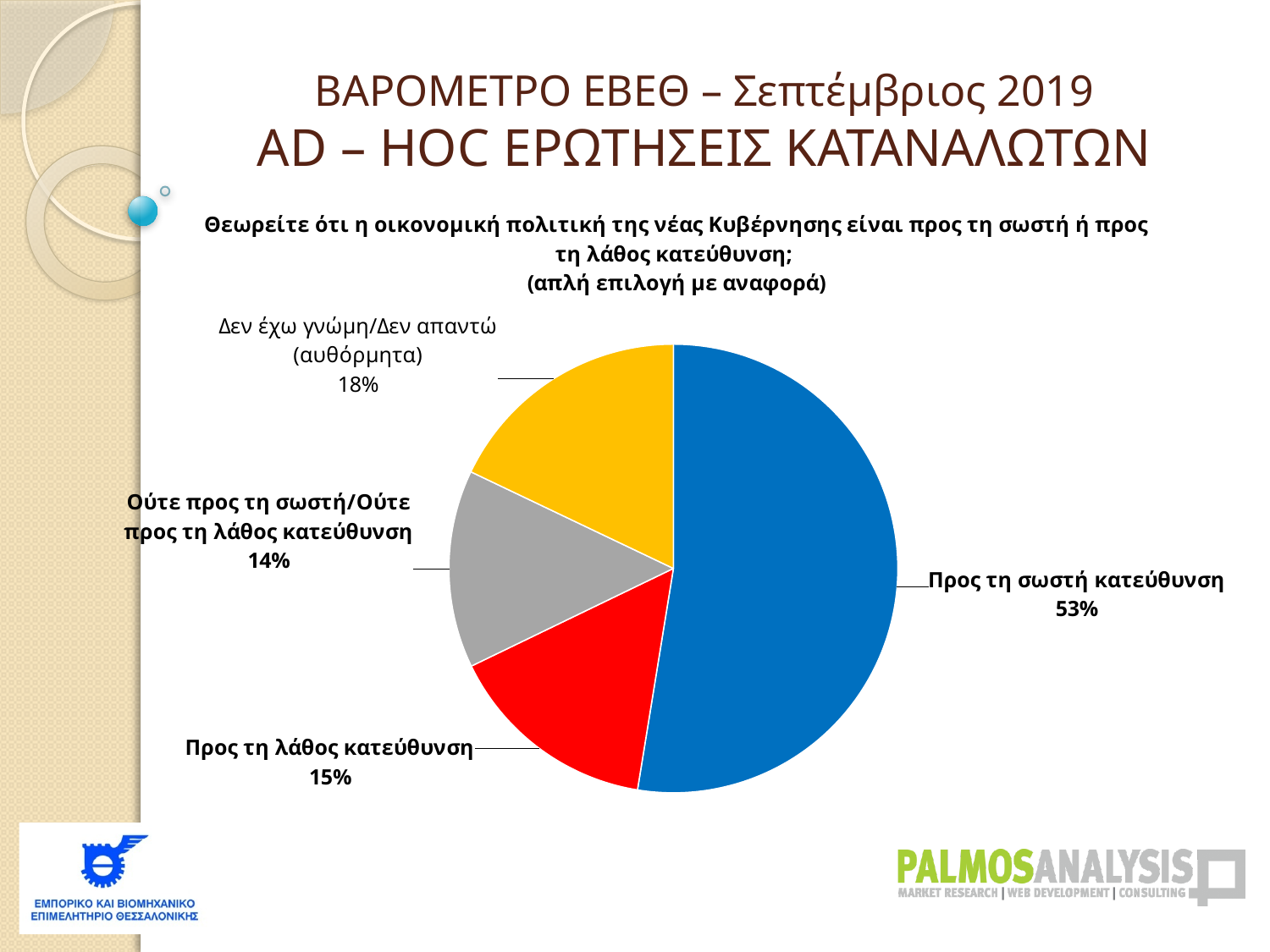
Which is larger: the share for "Δεν έχω γνώμη/Δεν απαντώ (αυθόρμητα)" or the share for "Προς τη λάθος κατεύθυνση"? Δεν έχω γνώμη/Δεν απαντώ (αυθόρμητα) What percentage of respondents answered "Προς τη λάθος κατεύθυνση"? 15% What kind of chart is shown on the slide? pie chart What percentage of respondents answered "Προς τη σωστή κατεύθυνση"? 53% What colour is the slice for "Προς τη σωστή κατεύθυνση"? blue What percentage of respondents answered "Ούτε προς τη σωστή/Ούτε προς τη λάθος κατεύθυνση"? 14% What percentage of respondents answered "Δεν έχω γνώμη/Δεν απαντώ (αυθόρμητα)"? 18% What is the difference in percentage points between "Προς τη σωστή κατεύθυνση" and "Προς τη λάθος κατεύθυνση"? 38 Which response has the smallest share of the pie? Ούτε προς τη σωστή/Ούτε προς τη λάθος κατεύθυνση What colour is the slice for "Προς τη λάθος κατεύθυνση"? red How many slices does the pie chart have? 4 Which response has the largest share of the pie? Προς τη σωστή κατεύθυνση